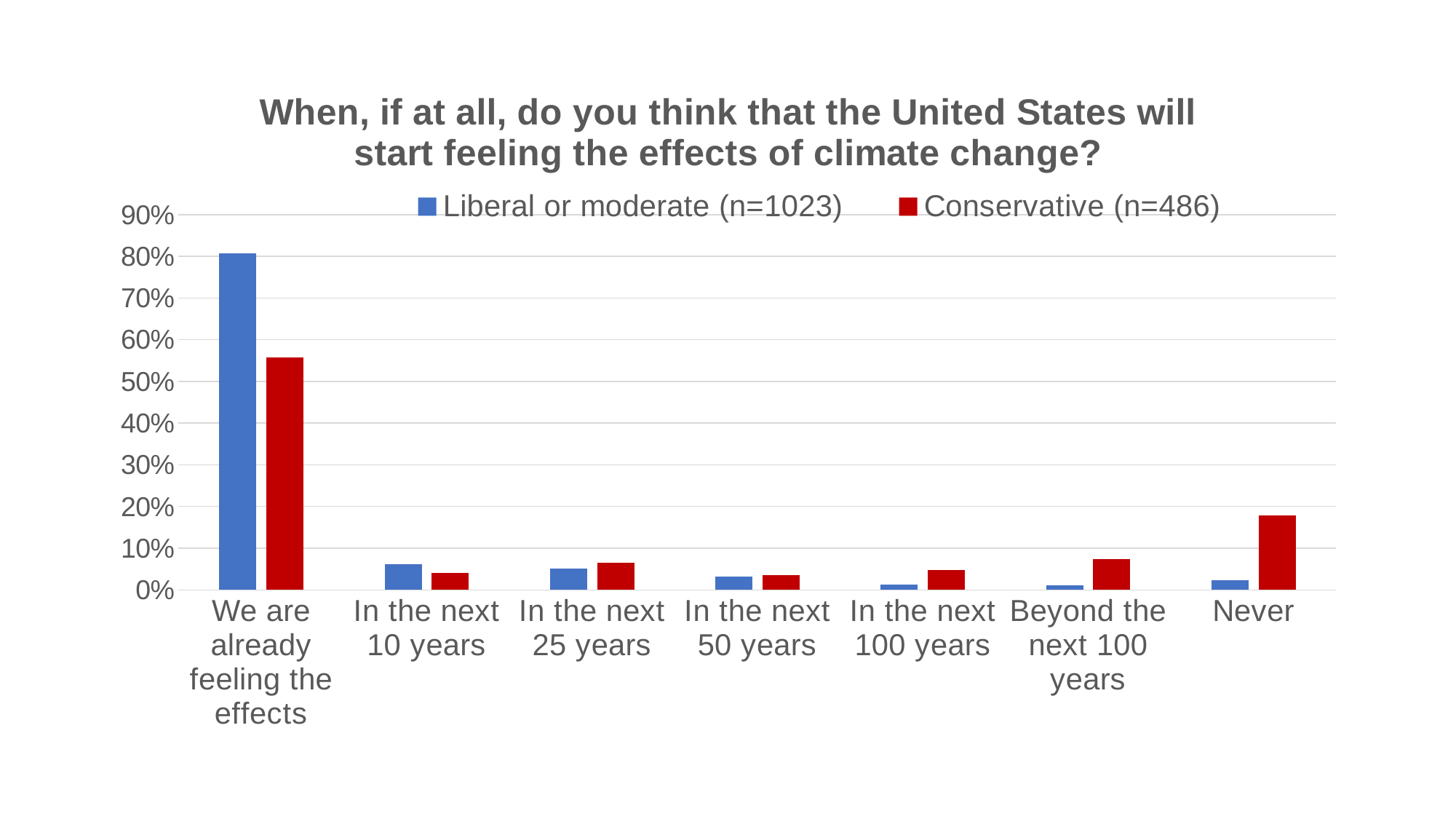
For the "Never" category, which series has the larger value? Conservative (n=486) How many response categories are shown on the x axis? 7 Is the Conservative value for "Never" greater or less than 10%? greater Is the Conservative value for "We are already feeling the effects" greater or less than 50%? greater For the "Beyond the next 100 years" category, which series has the larger value? Conservative (n=486) What kind of chart is shown on the slide? Bar chart Is the Liberal or moderate value for "We are already feeling the effects" greater or less than 70%? greater How many series does the legend list? 2 Which category has the highest value for the Liberal or moderate (n=1023) series? We are already feeling the effects Which category has the highest value for the Conservative (n=486) series? We are already feeling the effects What colour represents the Conservative (n=486) series? Red